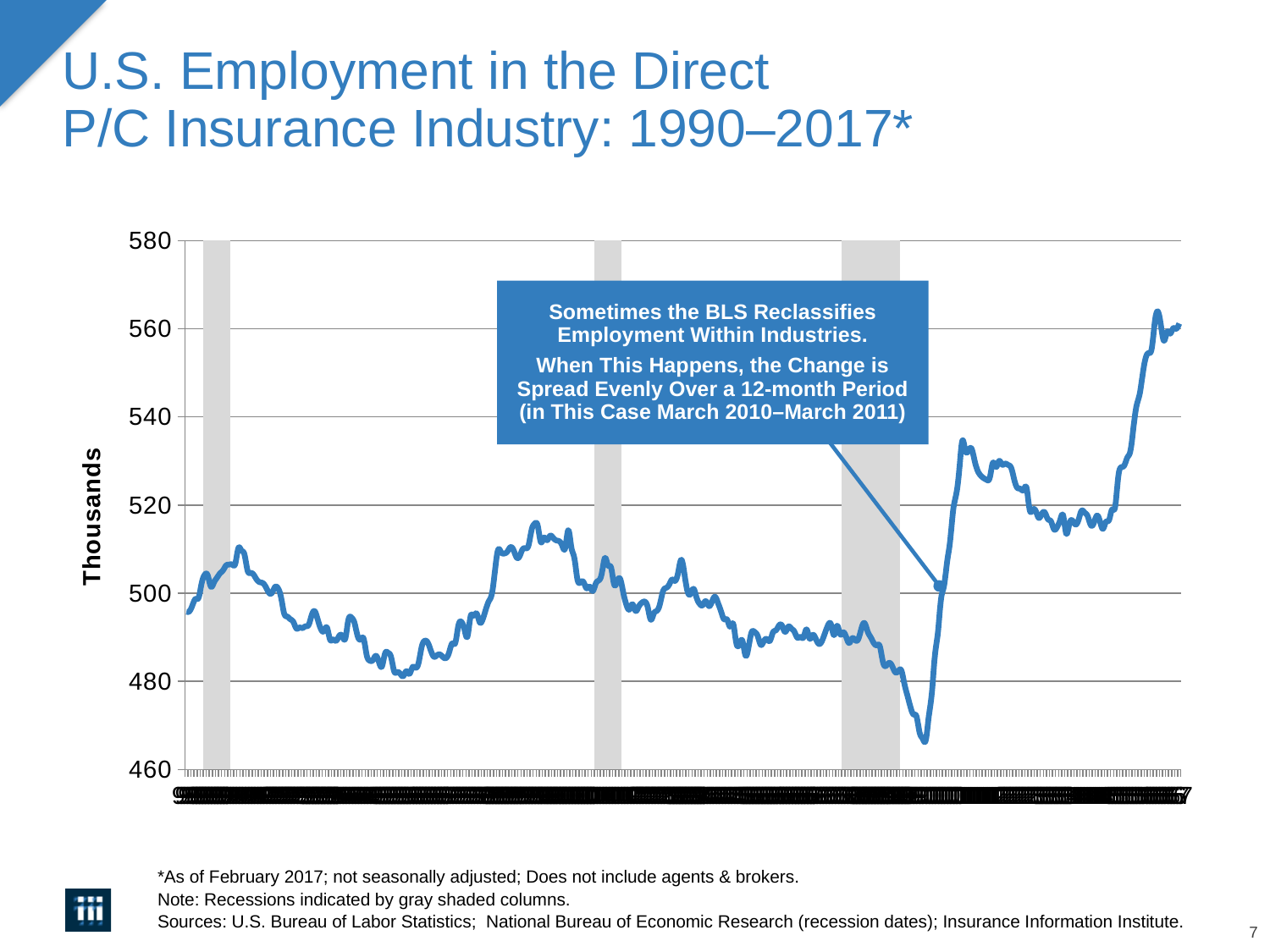
Is the highest point of the line greater or less than 540? greater What is the title of the chart on the slide? U.S. Employment in the Direct P/C Insurance Industry: 1990–2017* What is the label on the vertical axis of the chart? Thousands Is the value at the right-hand end of the line greater or less than 540? greater Is the value at the left-hand start of the line greater or less than 480? greater Over which 12-month period does the callout say the BLS reclassification change was spread? March 2010–March 2011 What kind of chart is shown on the slide? Line chart How many gray shaded recession columns appear on the chart? 3 Comparing the start of the series to the end of the series, does employment rise or fall overall? rise